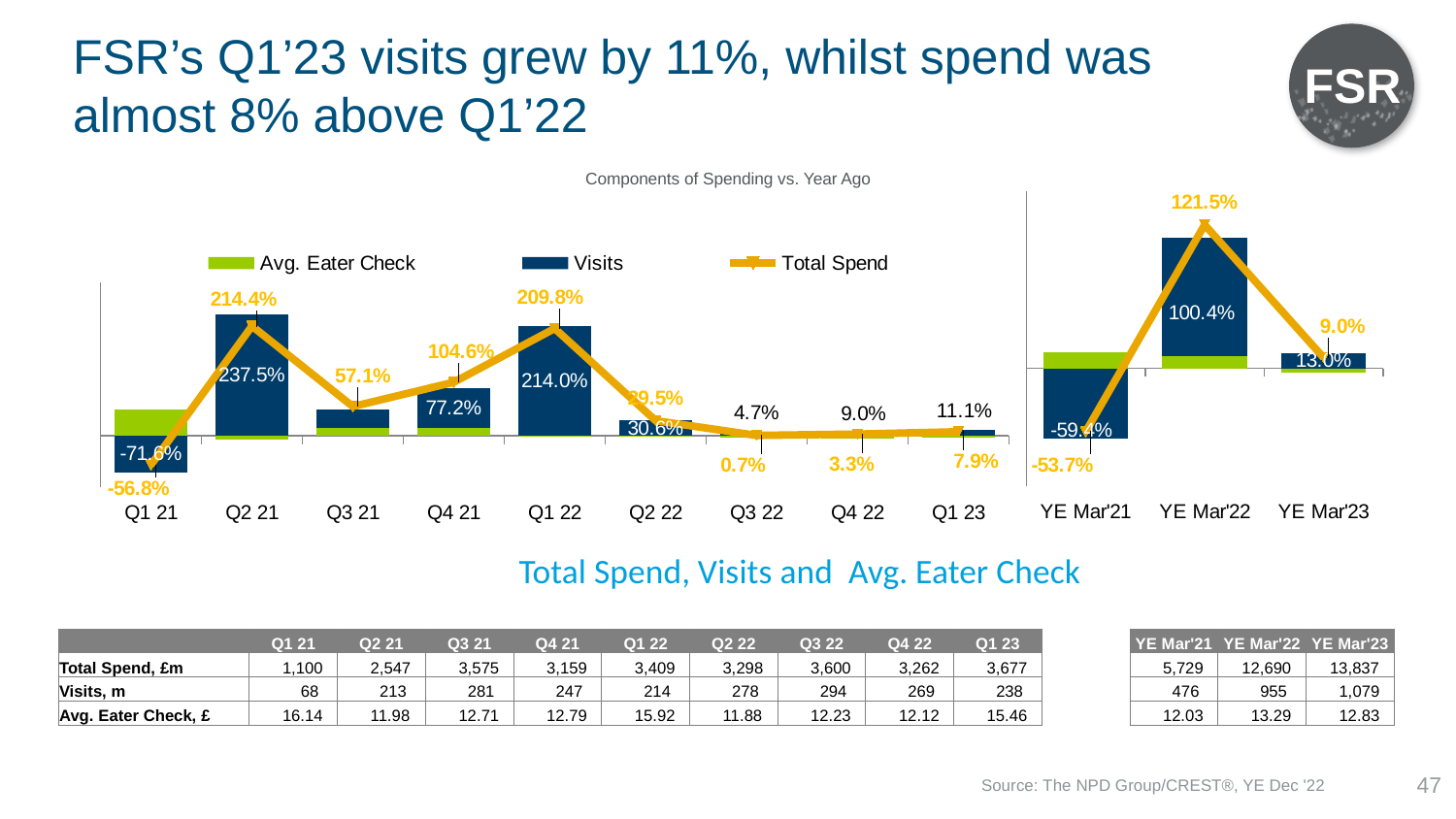
Which quarter has the highest Total Spend value in the Components of Spending vs. Year Ago chart? Q2 21 How many series does the legend of the Components of Spending vs. Year Ago chart list? 3 Which quarter has the lowest Total Spend value in the Components of Spending vs. Year Ago chart? Q1 21 What is the Total Spend value for Q2 21 in the Components of Spending vs. Year Ago chart? 214.4% What is the Total Spend value for Q1 23 in the Components of Spending vs. Year Ago chart? 7.9% What is the Total Spend value for YE Mar'22 in the right-hand panel of the chart? 121.5% What is the difference between the Visits values for Q1 23 and Q4 22 in the Components of Spending vs. Year Ago chart? 2.1 percentage points Which is larger in the Components of Spending vs. Year Ago chart: the Total Spend value for Q4 21 or for Q3 21? Q4 21 What is the Visits value for Q1 22 in the Components of Spending vs. Year Ago chart? 214.0% How many quarters are shown on the x axis of the left-hand panel of the Components of Spending vs. Year Ago chart? 9 What is the Visits value for YE Mar'21 in the right-hand panel of the chart? -59.4% Which series in the Components of Spending vs. Year Ago chart is drawn as an orange line? Total Spend